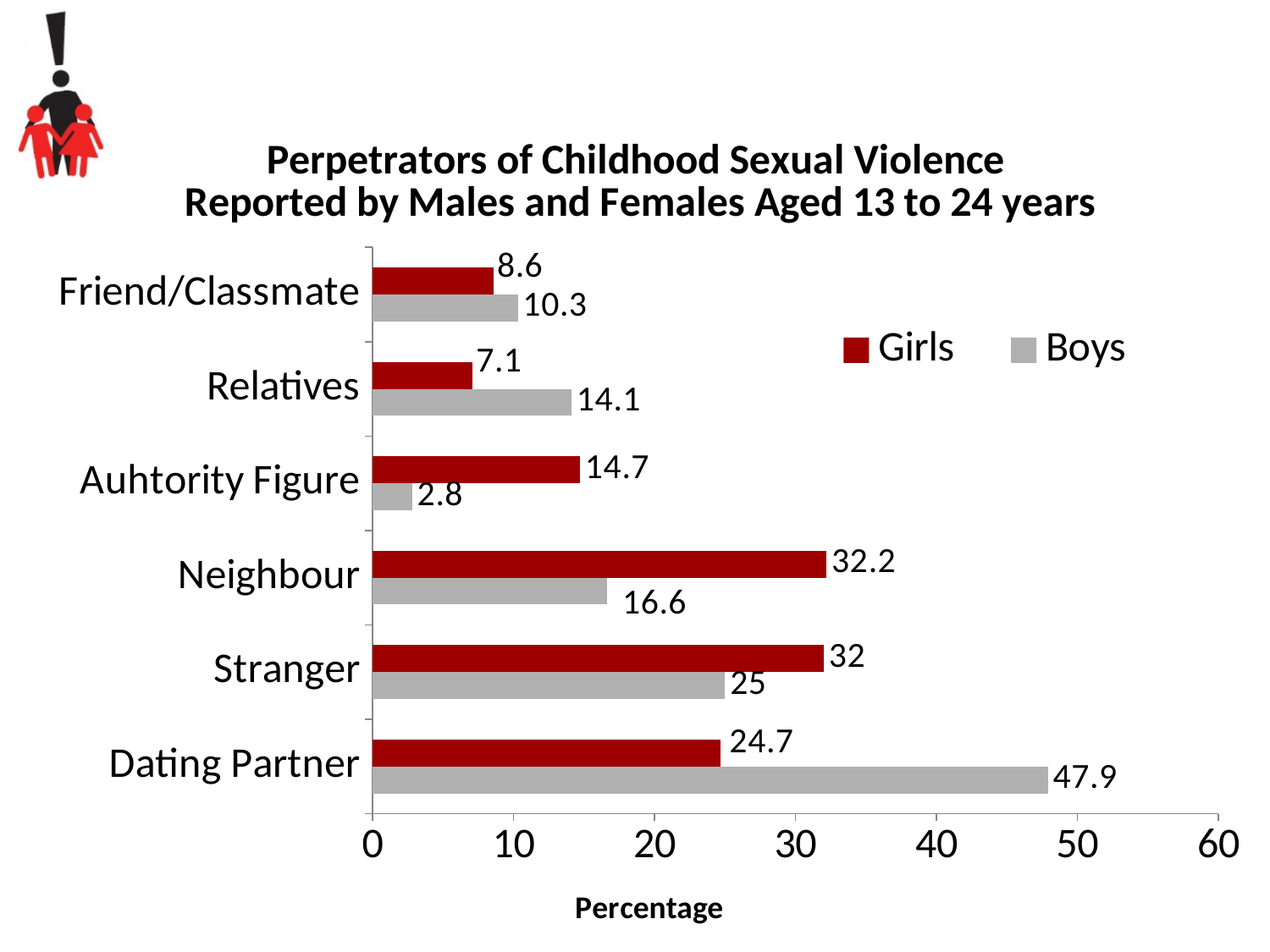
Which category has the highest value for Boys? Dating Partner What is the value for Boys in the Auhtority Figure category? 2.8 What is the difference between the Boys and Girls values for Dating Partner? 23.2 What kind of chart is shown on the slide? Bar chart What is the difference between the Girls and Boys values for Neighbour? 15.6 How many series does the legend list? 2 How many perpetrator categories are shown on the chart? 6 What is the value for Girls in the Dating Partner category? 24.7 What is the value for Boys in the Relatives category? 14.1 Is the value for Boys in the Dating Partner category greater or less than 40? greater Which is larger for Stranger, the Girls value or the Boys value? Girls Which category has the lowest value for Girls? Relatives